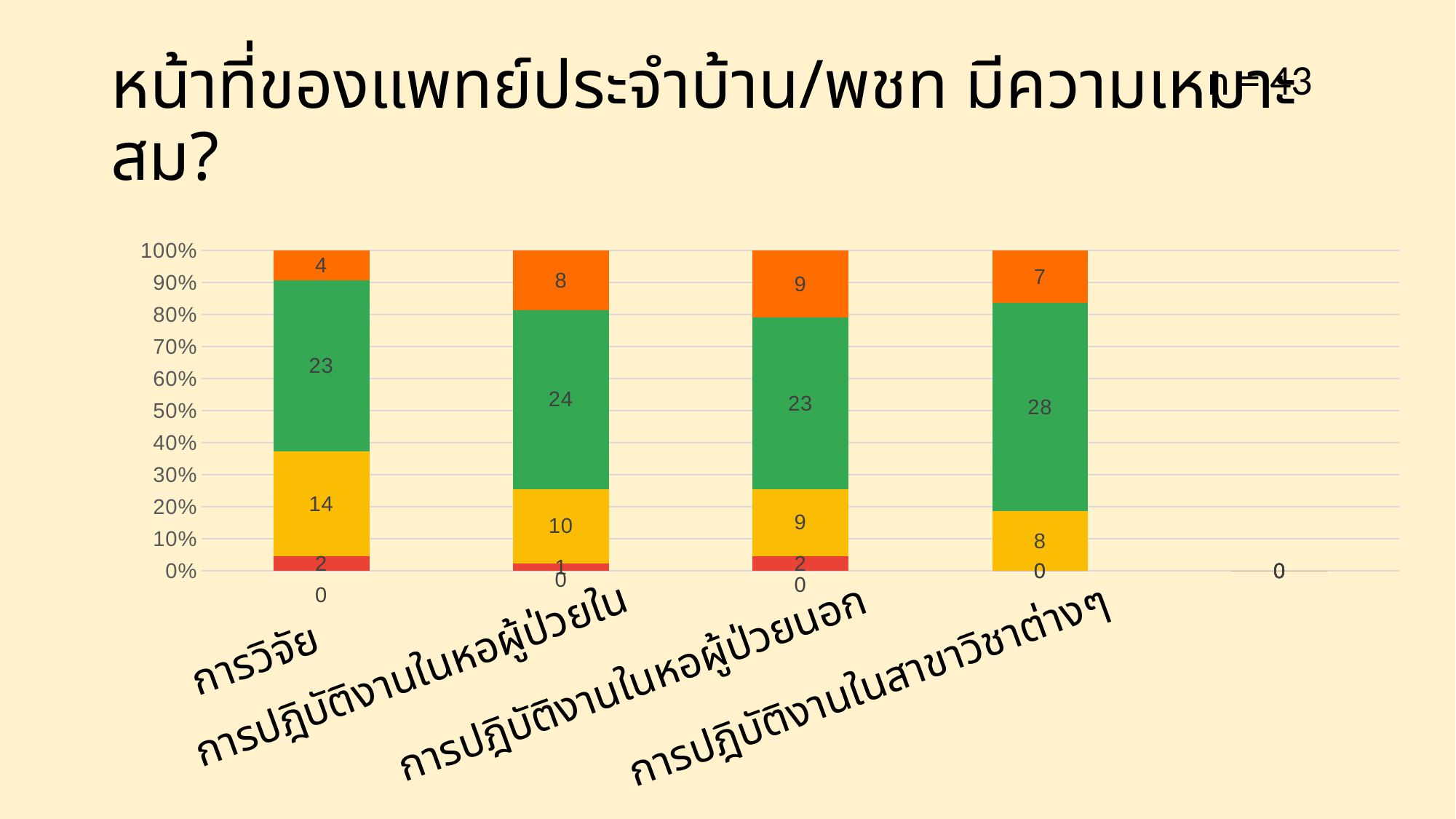
Which is larger: the green segment for การปฏิบัติงานในหอผู้ป่วยใน or the green segment for การปฏิบัติงานในหอผู้ป่วยนอก? การปฏิบัติงานในหอผู้ป่วยใน What type of chart is shown on the slide? stacked bar chart What is the maximum value shown on the y axis of the chart? 100% Which category has the largest green segment value? การปฏิบัติงานในสาขาวิชาต่างๆ What is the difference between the yellow segment values for การวิจัย and การปฏิบัติงานในสาขาวิชาต่างๆ? 6 What is the value of the yellow segment for การปฏิบัติงานในหอผู้ป่วยใน? 10 What is the value of the red segment for การปฏิบัติงานในหอผู้ป่วยใน? 1 How many labelled categories are shown along the x axis of the chart? 4 What is the value of the green segment for การวิจัย? 23 What is the total of all labelled segments in the bar for การปฏิบัติงานในสาขาวิชาต่างๆ? 43 What is the value of the orange segment for การปฏิบัติงานในหอผู้ป่วยนอก? 9 Which category has the smallest orange segment value? การวิจัย